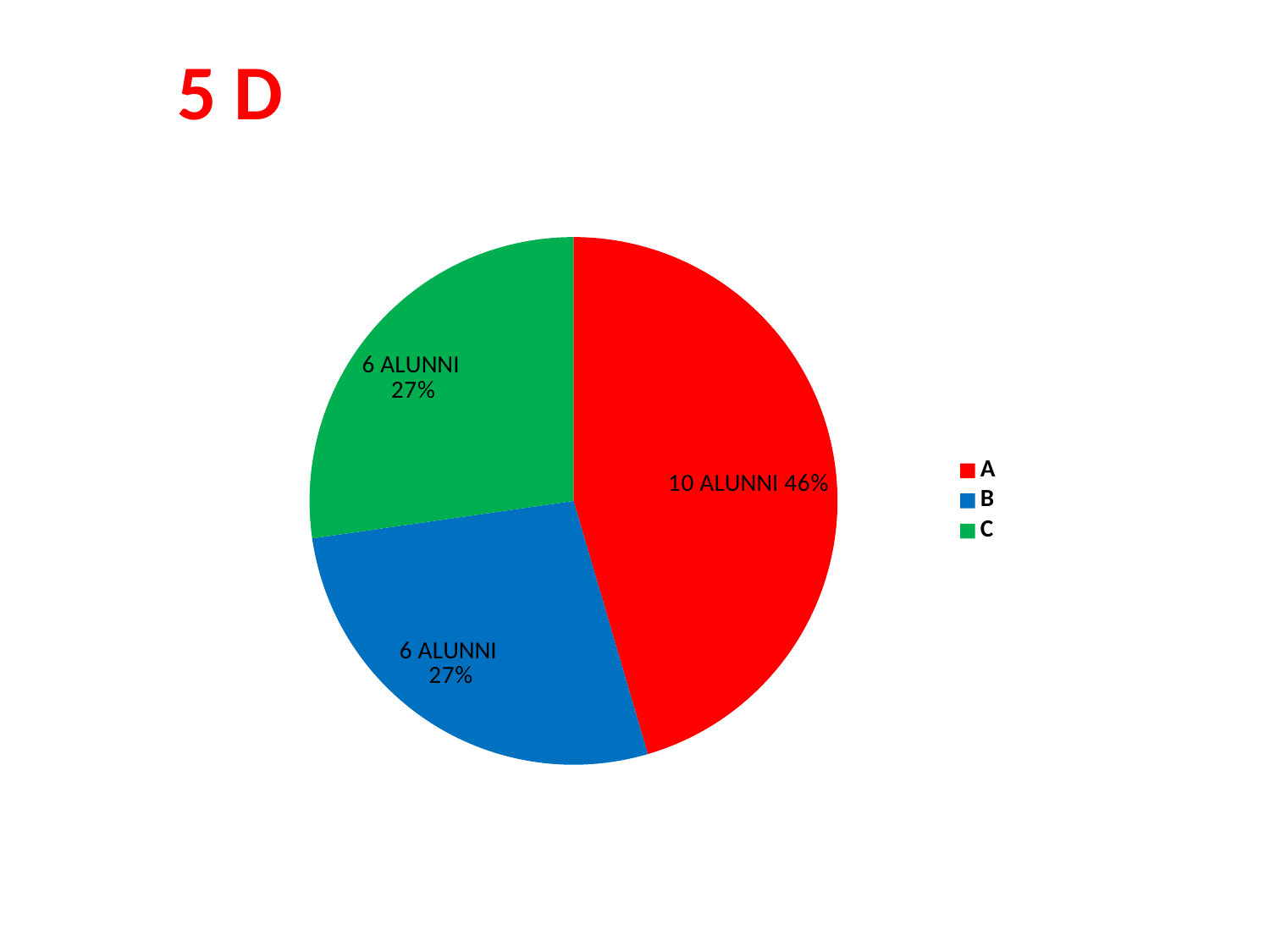
What colour is the slice for category C? green What percentage share does slice B have? 27% How many alunni are in category A? 10 ALUNNI What is the difference in alunni between category A and category C? 4 Which is larger, the slice for A or the slice for B? A Which category has the largest slice? A What percentage share does slice A have? 46% How many entries does the legend list? 3 What percentage share does slice C have? 27% What kind of chart is shown on the slide? pie chart How many slices does the pie chart have? 3 How many alunni are in category B? 6 ALUNNI